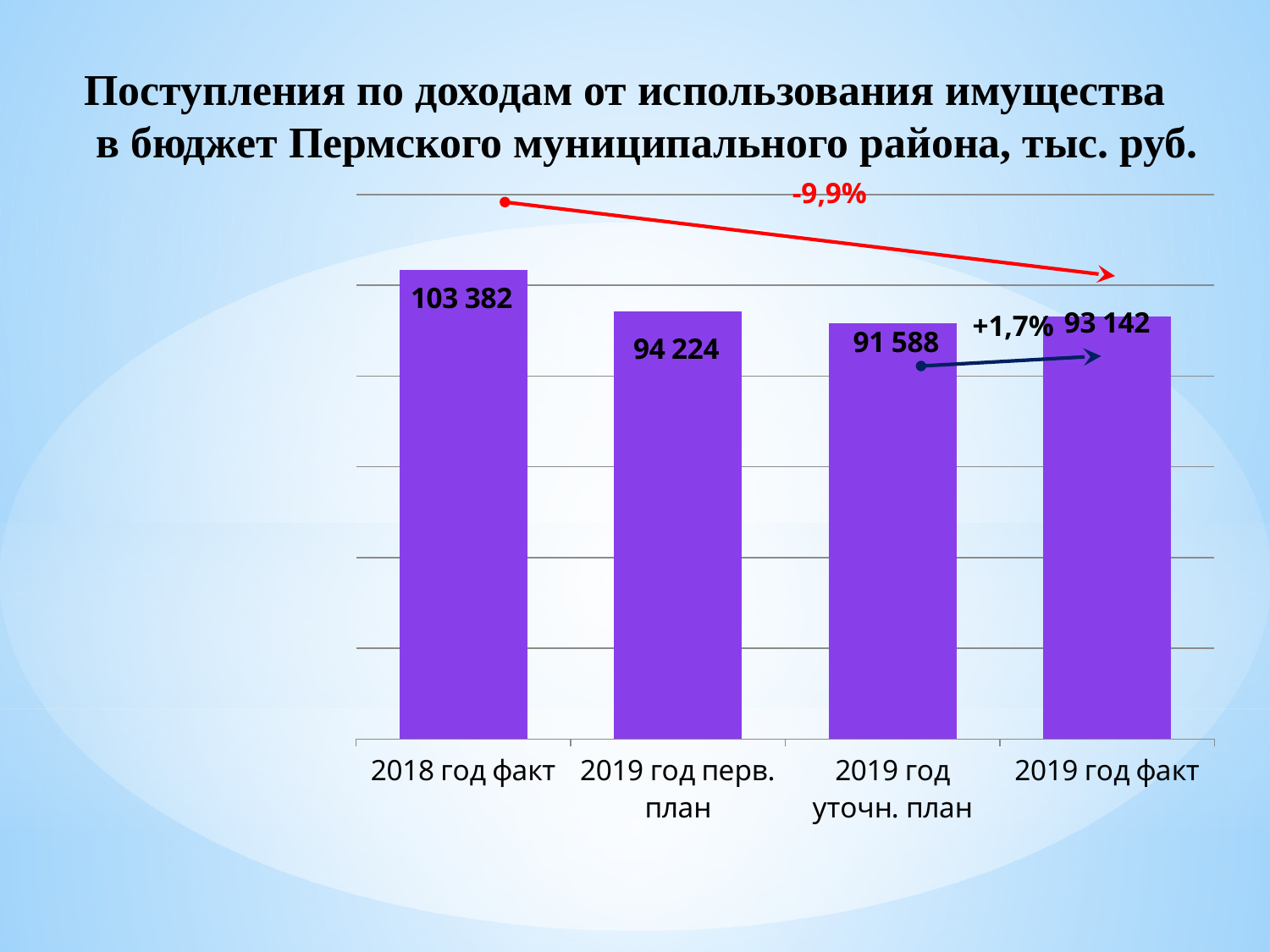
Which is larger, the value for 2019 год перв. план or 2019 год факт? 2019 год перв. план What is the difference between the values for 2019 год факт and 2019 год уточн. план? 1 554 What is the value for 2019 год факт? 93 142 What is the difference between the values for 2018 год факт and 2019 год факт? 10 240 What kind of chart is shown on the slide? bar chart Which category has the lowest value? 2019 год уточн. план How many categories are shown on the chart? 4 What percentage change is shown by the red arrow from 2018 год факт to 2019 год факт? -9,9% What is the value for 2019 год перв. план? 94 224 What is the value for 2019 год уточн. план? 91 588 What is the value for 2018 год факт? 103 382 Which category has the highest value? 2018 год факт